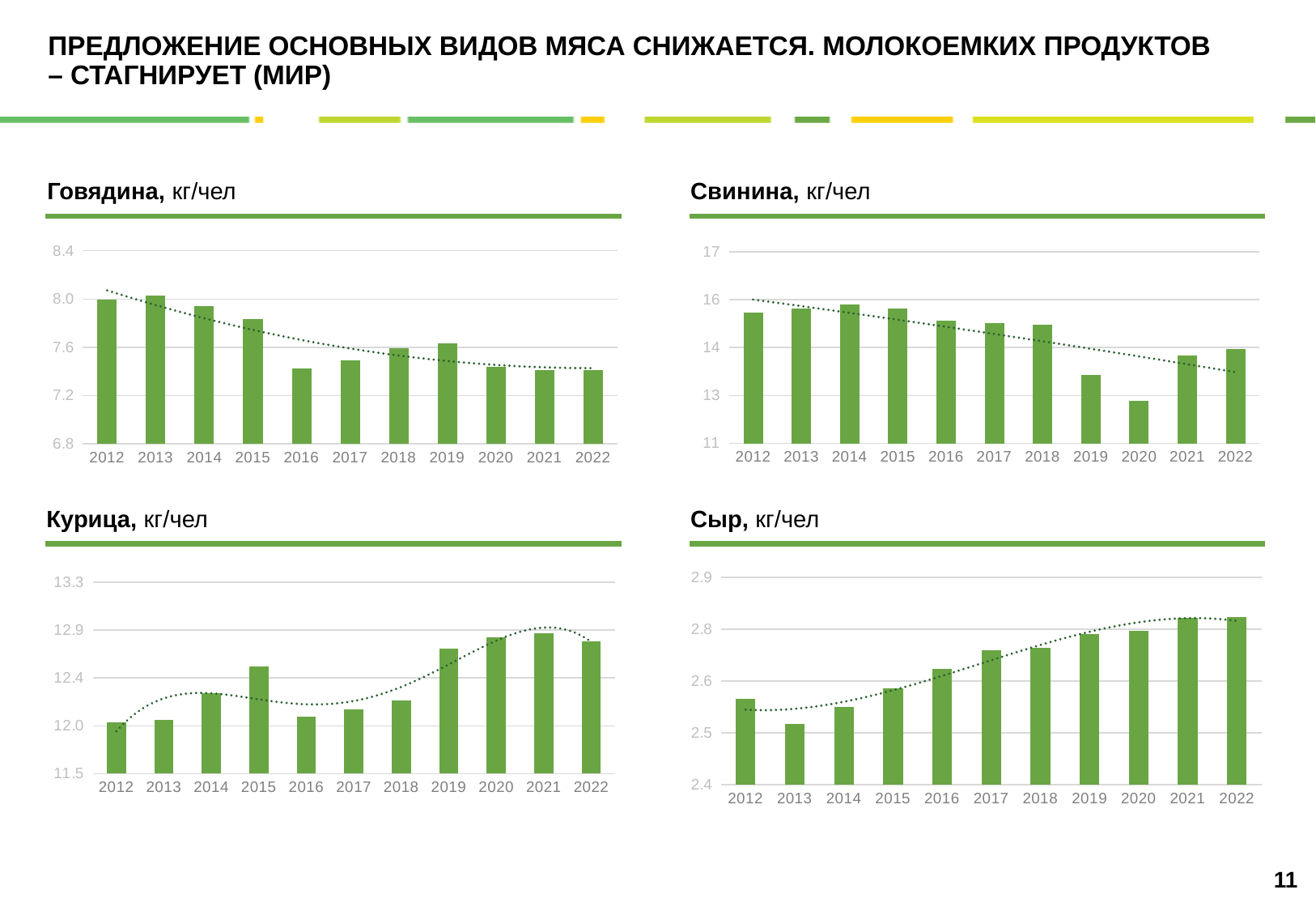
In the Курица, кг/чел chart, which is larger, the value for 2015 or the value for 2016? 2015 In the Говядина, кг/чел chart, is the value for 2016 greater or less than 7.6? less In the Курица, кг/чел chart, is the value for 2015 greater or less than 12.4? greater In the Свинина, кг/чел chart, which year has the lowest value? 2020 In the Говядина, кг/чел chart, is the value for 2015 greater or less than 7.6? greater How many years are shown on the x axis of the Свинина, кг/чел chart? 11 In the Сыр, кг/чел chart, which year has the lowest value? 2013 In the Свинина, кг/чел chart, which is larger, the value for 2019 or the value for 2020? 2019 What kind of chart is the Говядина, кг/чел chart? bar chart In the Говядина, кг/чел chart, do the values generally rise or fall from 2012 to 2022? fall